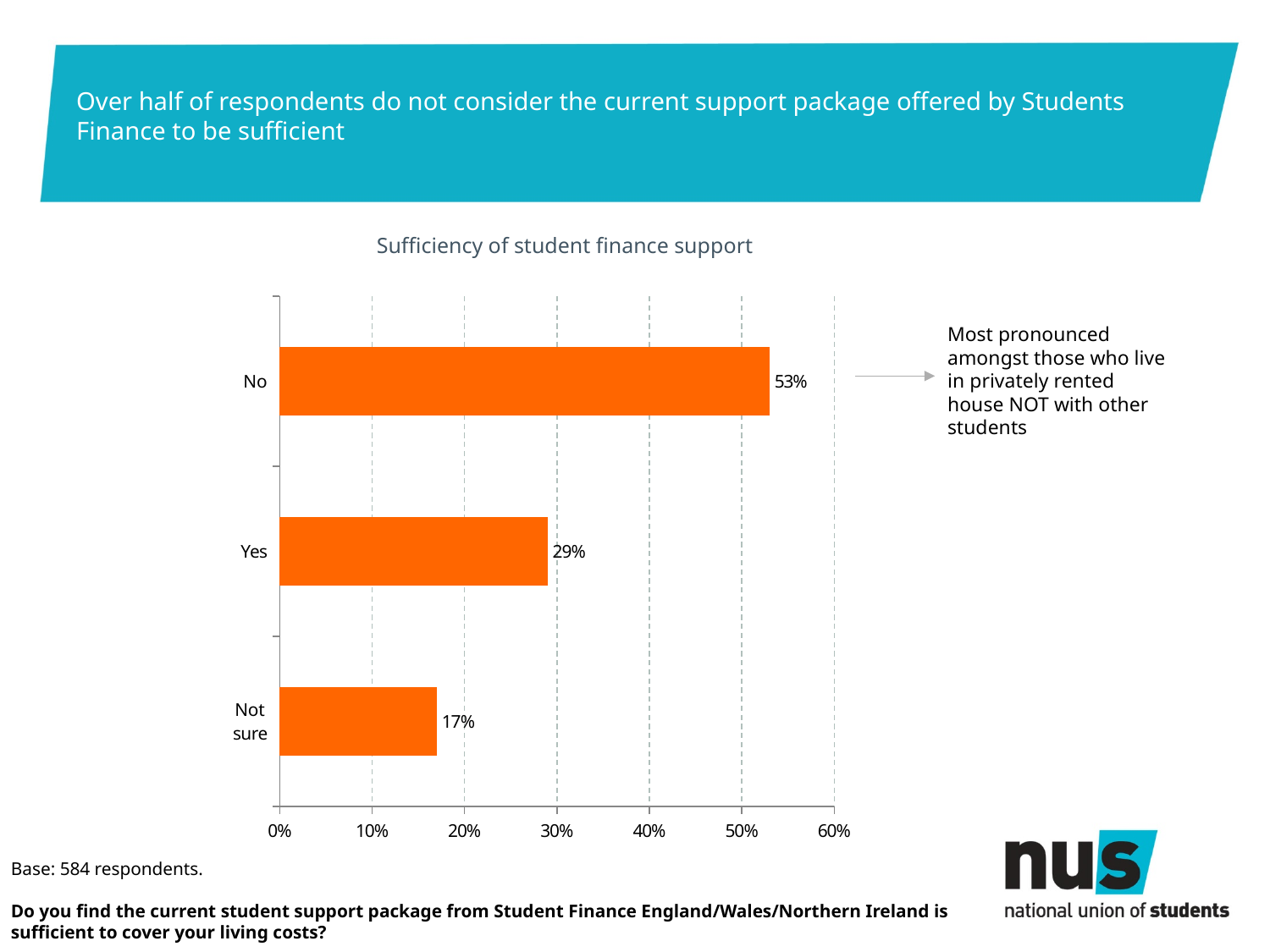
Which response category has the highest percentage? No How many response categories are shown in the chart? 3 What is the title of the chart? Sufficiency of student finance support What type of chart is used to show the sufficiency of student finance support? Bar chart What percentage of respondents answered "Yes"? 29% Which is larger, the value for "Yes" or the value for "Not sure"? Yes What is the difference in percentage points between the "No" and "Yes" responses? 24 Which response category has the lowest percentage? Not sure What percentage of respondents answered "Not sure"? 17% What is the difference in percentage points between the "Yes" and "Not sure" responses? 12 What percentage of respondents answered "No" in the Sufficiency of student finance support chart? 53% Is the value for "No" greater or less than 50%? greater